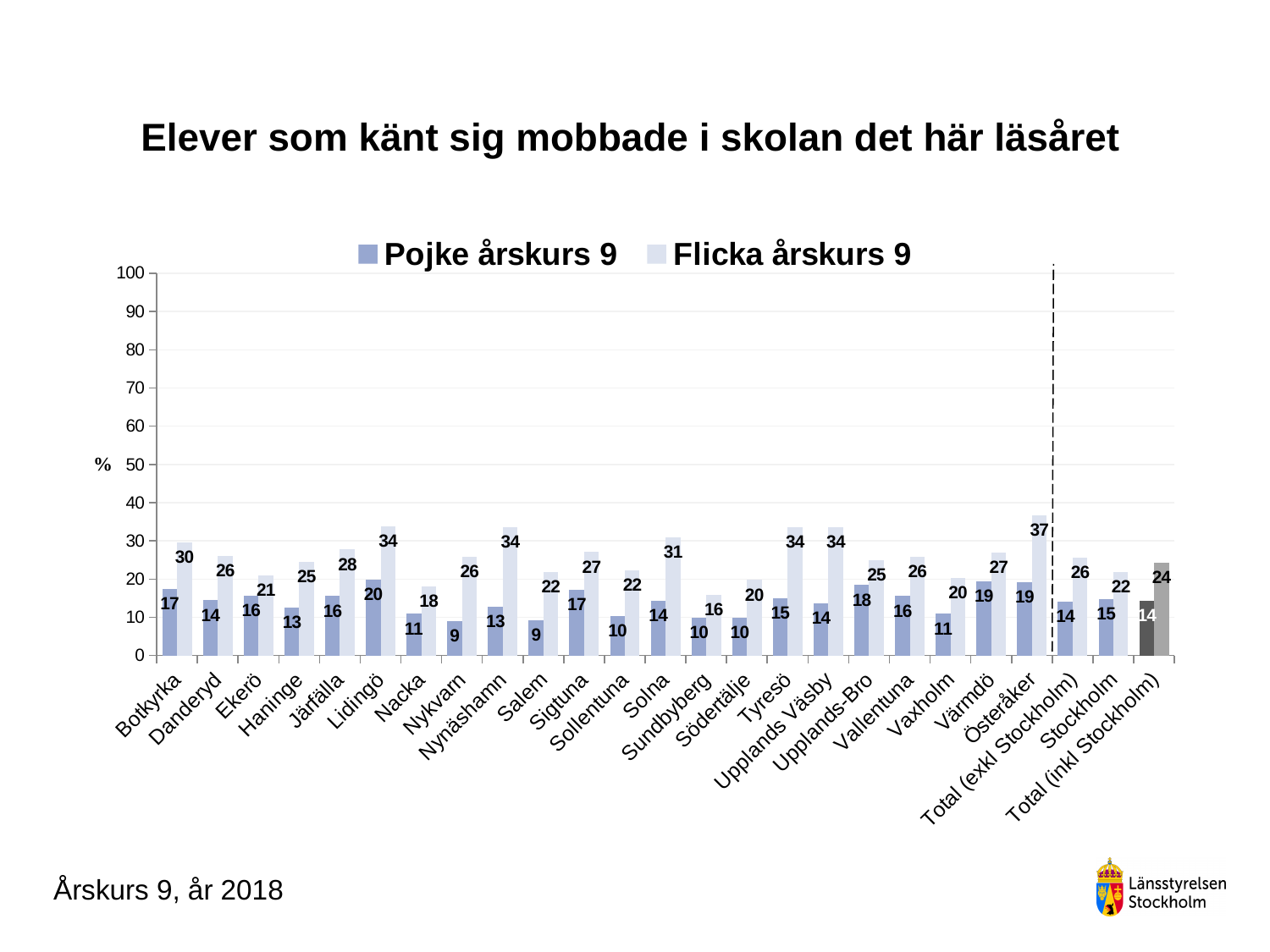
What is the value for Flicka årskurs 9 in Nynäshamn? 34 What is the value for Flicka årskurs 9 in Österåker? 37 Which category has the highest value for Flicka årskurs 9? Österåker What is the title of the chart? Elever som känt sig mobbade i skolan det här läsåret Which category has the lowest value for Flicka årskurs 9? Sundbyberg How many categories are shown on the x axis? 25 How many series does the legend list? 2 What is the difference between the Flicka årskurs 9 and Pojke årskurs 9 values in Nykvarn? 17 What is the value for Pojke årskurs 9 in Lidingö? 20 Which category has the highest value for Pojke årskurs 9? Lidingö Which is larger: the Flicka årskurs 9 value for Solna or for Sigtuna? Solna What kind of chart is shown on the slide? Bar chart